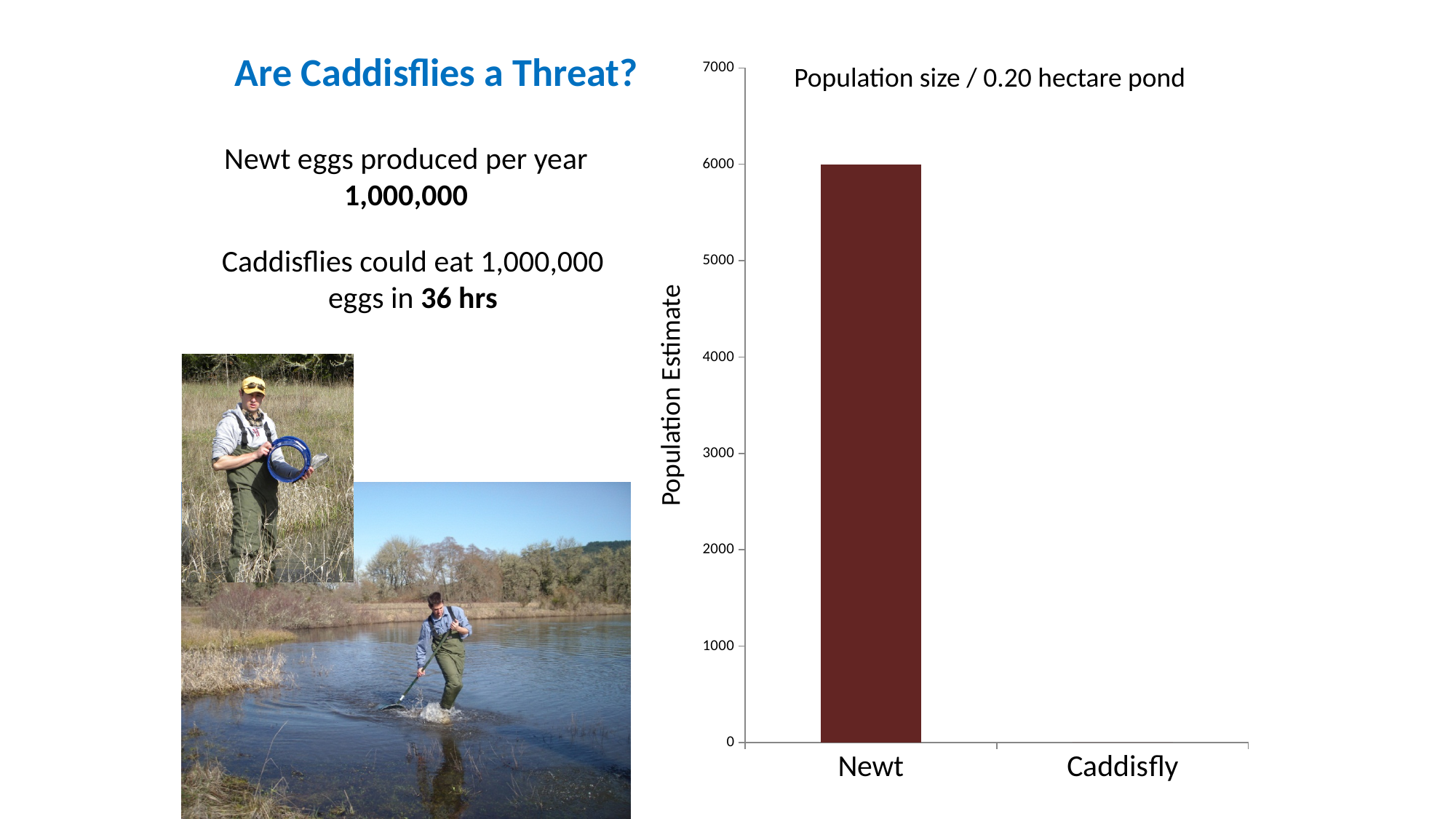
What kind of chart is shown on the slide? bar chart What is the highest value shown on the vertical axis? 7000 How many categories are shown on the x axis of the chart? 2 What is the label on the vertical axis of the chart? Population Estimate What is the title of the chart? Population size / 0.20 hectare pond What is the population estimate for Newt? 6000 Which has the larger population estimate, Newt or Caddisfly? Newt Which category has the highest population estimate? Newt Is the population estimate for Newt greater or less than 7000? less Is the population estimate for Newt greater or less than 5000? greater